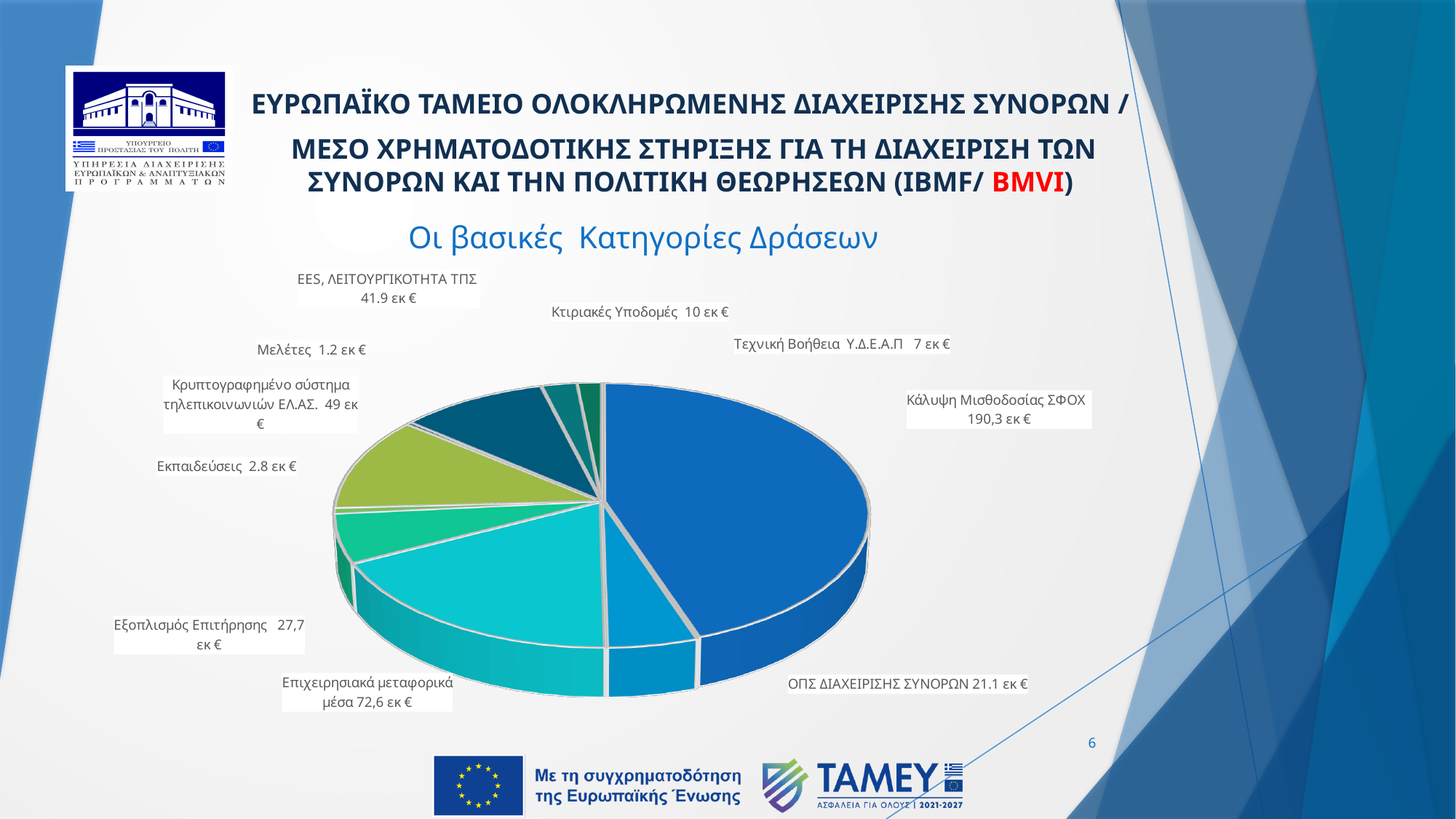
What is the value for Επιχειρησιακά μεταφορικά μέσα? 72,6 εκ € Which category has the largest value? Κάλυψη Μισθοδοσίας ΣΦΟΧ What is the difference between Κάλυψη Μισθοδοσίας ΣΦΟΧ and Επιχειρησιακά μεταφορικά μέσα? 117,7 εκ € Which category has the smallest value? Μελέτες What is the title of the chart? Οι βασικές Κατηγορίες Δράσεων Which is larger, Επιχειρησιακά μεταφορικά μέσα or Κρυπτογραφημένο σύστημα τηλεπικοινωνιών ΕΛ.ΑΣ.? Επιχειρησιακά μεταφορικά μέσα What kind of chart is shown on the slide? Pie chart What is the difference between Κτιριακές Υποδομές and Τεχνική Βοήθεια Υ.Δ.Ε.Α.Π? 3 εκ € What is the value for ΟΠΣ ΔΙΑΧΕΙΡΙΣΗΣ ΣΥΝΟΡΩΝ? 21.1 εκ € What is the value for Κάλυψη Μισθοδοσίας ΣΦΟΧ? 190,3 εκ € How many categories does the pie chart show? 10 What is the value for EES, ΛΕΙΤΟΥΡΓΙΚΟΤΗΤΑ ΤΠΣ? 41.9 εκ €